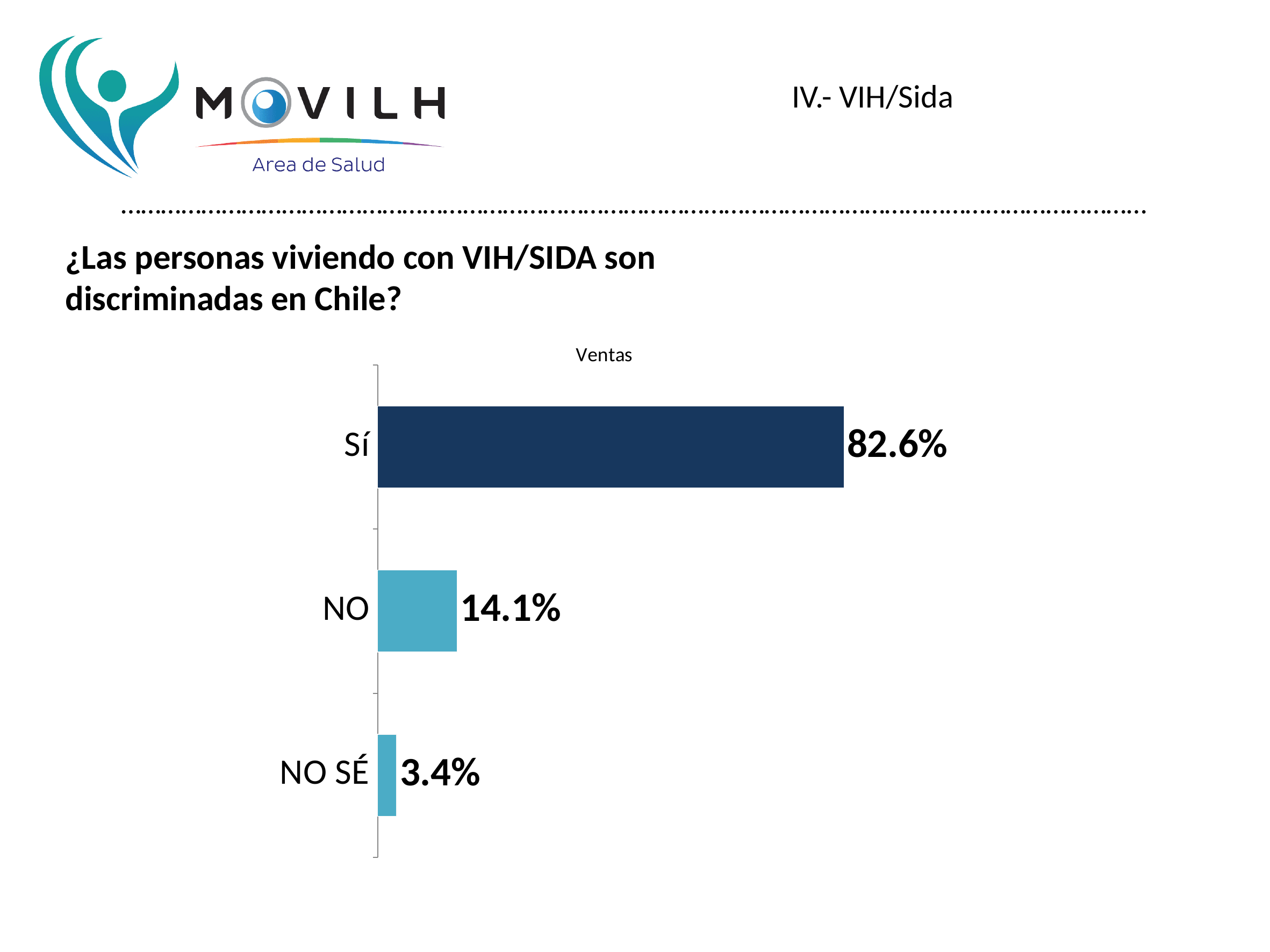
What is the value for NO SÉ? 3.4% What is the difference between the values for Sí and NO? 68.5% What is the title shown above the chart? Ventas Which is larger, the value for NO or the value for NO SÉ? NO How many categories are shown in the chart? 3 What is the value for Sí? 82.6% What is the value for NO? 14.1% Which category has the highest value? Sí What is the difference between the values for NO and NO SÉ? 10.7% What kind of chart is shown on the slide? Bar chart Which category has the lowest value? NO SÉ What colour is the bar for Sí? Dark navy blue